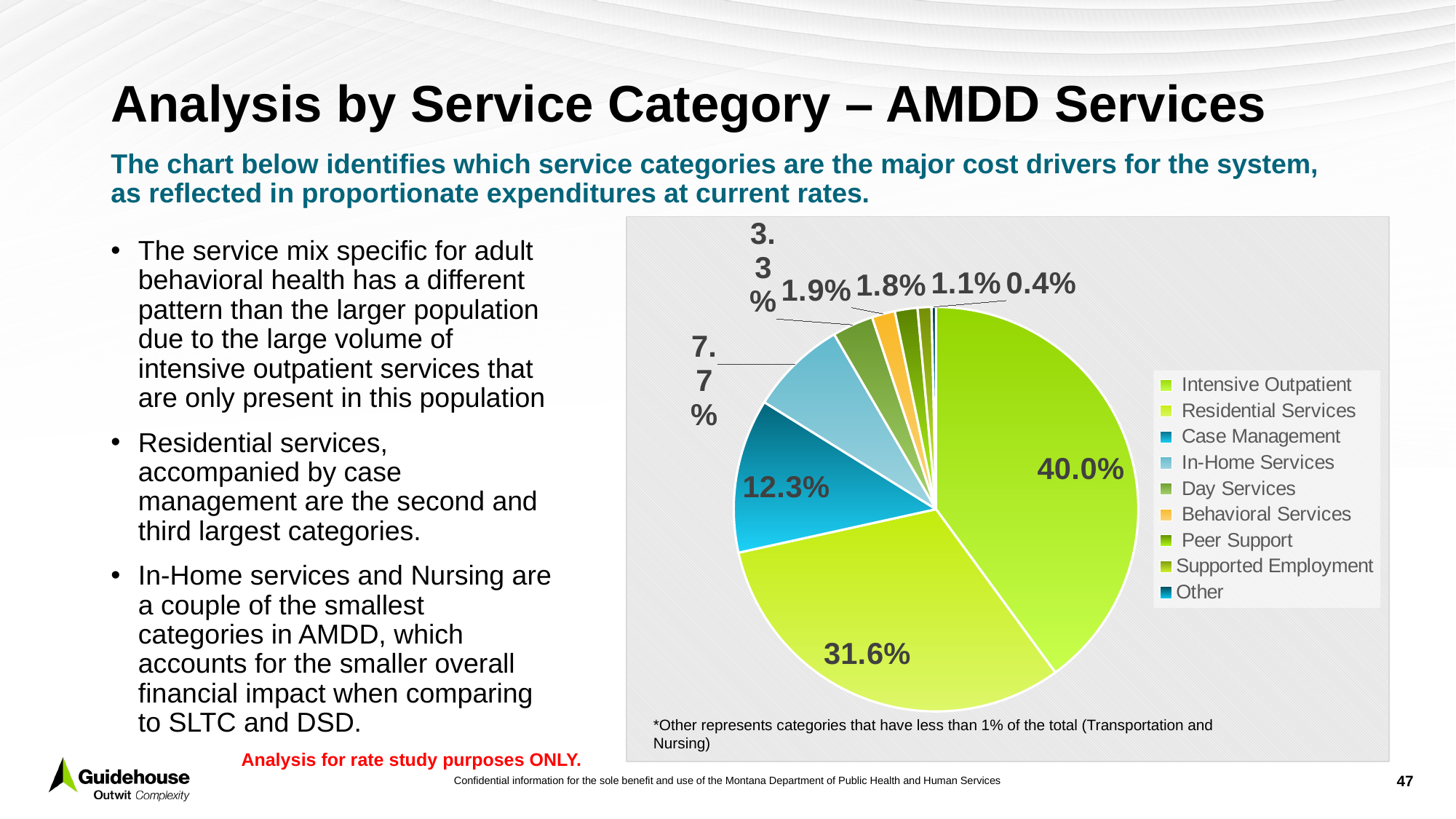
Which is larger, the share for Case Management or the share for In-Home Services? Case Management How many service categories does the legend list? 9 What kind of chart is shown on the slide? Pie chart What share of expenditures does Behavioral Services account for? 1.9% According to the footnote, which categories are included in 'Other'? Transportation and Nursing What is the difference in percentage points between Intensive Outpatient and Residential Services? 8.4 What share of expenditures does Case Management account for? 12.3% Which service category has the smallest share of the pie? Other Which service category has the largest share of the pie? Intensive Outpatient What share of expenditures does Intensive Outpatient account for? 40.0% What share of expenditures does Residential Services account for? 31.6% What share of expenditures does In-Home Services account for? 7.7%